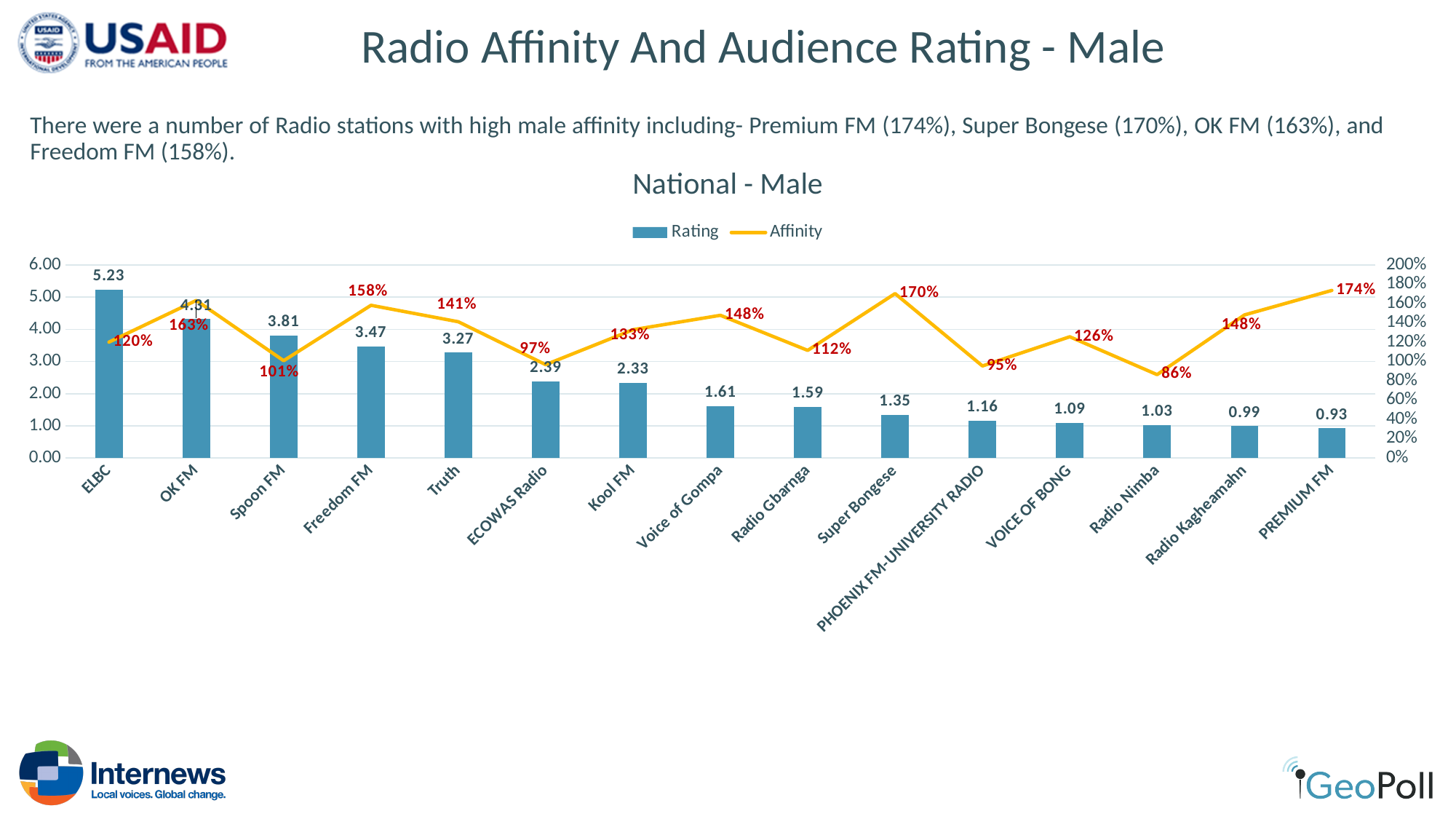
Which station has the highest Affinity? PREMIUM FM Which station has the lowest Rating? PREMIUM FM How many series does the legend list? 2 What is the difference in Rating between ELBC and OK FM? 0.92 Which station has the lowest Affinity? Radio Nimba What is the Affinity value for Super Bongese? 170% What is the Rating value for ELBC? 5.23 What is the title of the chart? National - Male Which has a higher Affinity, Truth or ECOWAS Radio? Truth What is the difference in Affinity between Freedom FM and Spoon FM? 57% What is the Rating value for Kool FM? 2.33 How many radio stations are shown on the x axis? 15